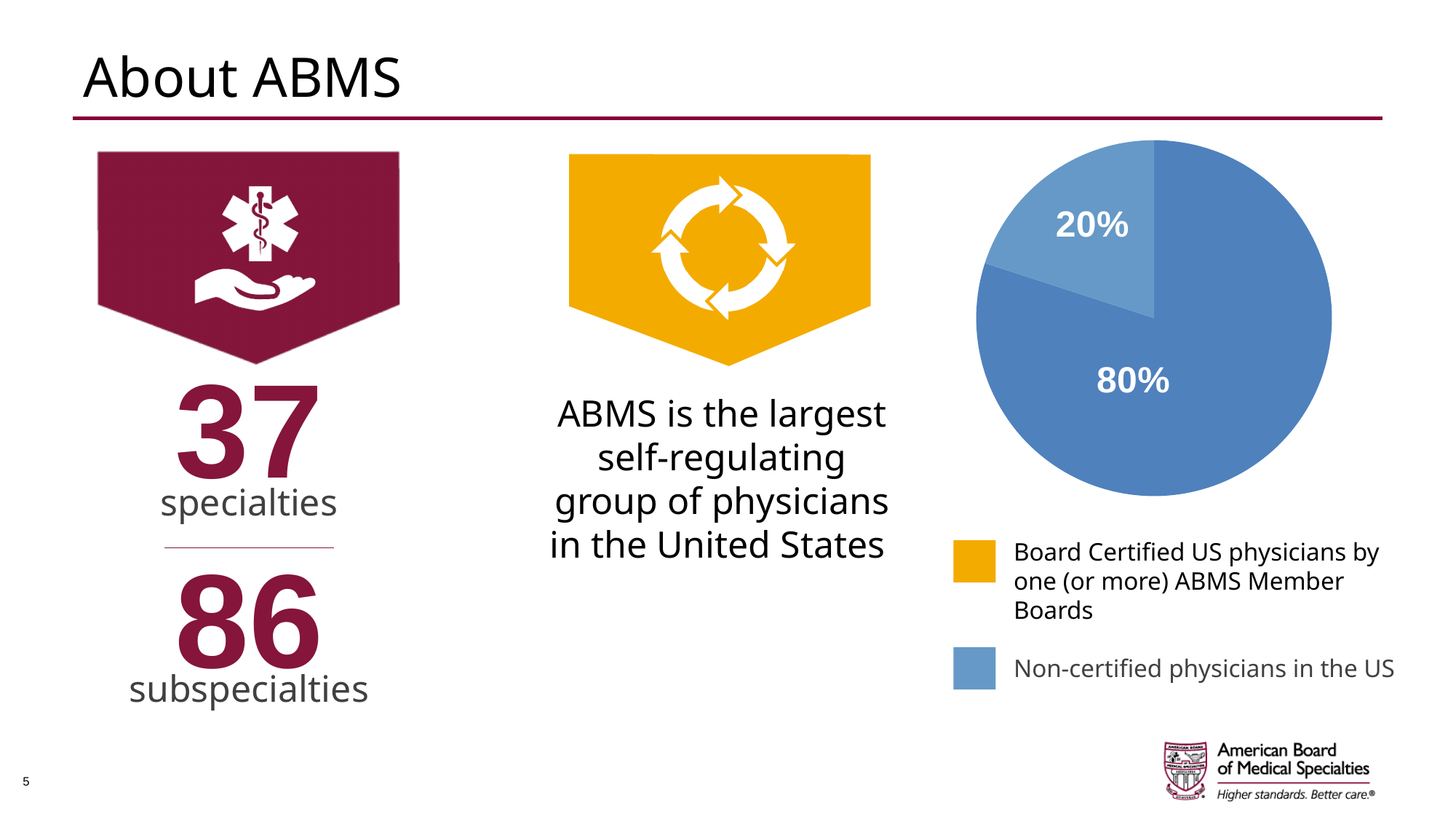
Which slice of the pie chart is larger, 80% or 20%? 80% What is the difference in percentage points between the two slices of the pie chart? 60 What share of the pie chart is labelled for Non-certified physicians in the US? 20% How many slices does the pie chart have? 2 How many entries does the legend of the pie chart list? 2 What is the legend label for the light blue entry in the pie chart's legend? Non-certified physicians in the US What is the largest slice's value in the pie chart? 80% What is the total of the two slices shown in the pie chart? 100% What share of the pie chart is labelled for Board Certified US physicians by one (or more) ABMS Member Boards? 80% What is the smallest slice's value in the pie chart? 20% What kind of chart is shown on the slide? pie chart Is the value of the larger slice in the pie chart greater or less than 50%? greater